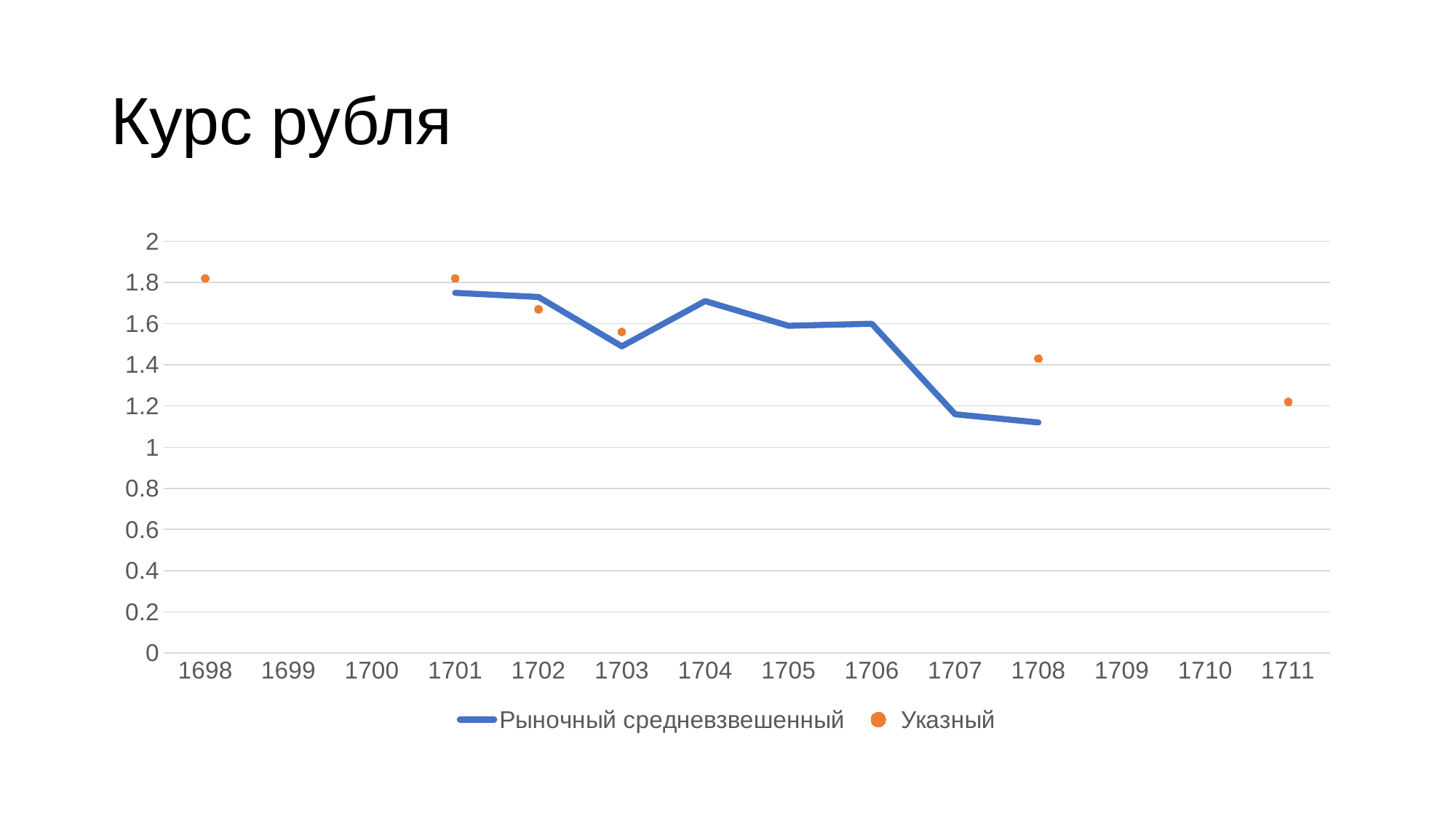
Does the Рыночный средневзвешенный line overall rise or fall from 1701 to 1708? fall Is the Указный value for 1698 greater or less than 1.6? greater How many points are plotted for the Указный series? 6 For Рыночный средневзвешенный, which is larger: the value for 1706 or the value for 1707? 1706 What kind of chart is shown on the slide? line chart Is the value of Рыночный средневзвешенный for 1701 greater or less than 1.6? greater How many years are labelled on the x axis? 14 Is the Указный value for 1708 greater or less than 1.6? less For Рыночный средневзвешенный, which is larger: the value for 1703 or the value for 1704? 1704 In which year is the Указный value lowest? 1711 How many series does the legend list? 2